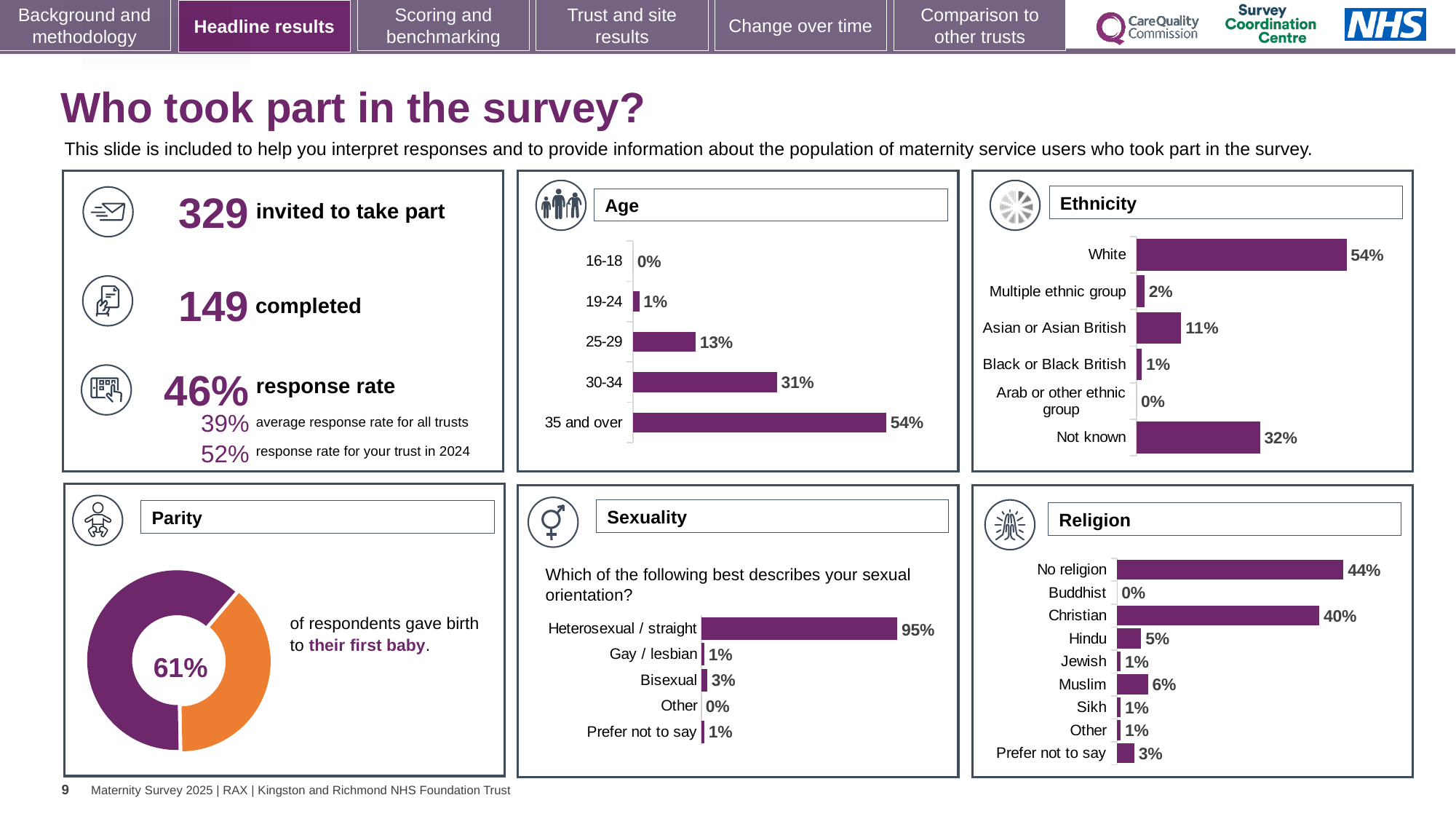
What kind of chart is the Parity chart? Doughnut chart In the Ethnicity chart, which category has the highest value? White In the Age chart, what percentage of respondents were aged 35 and over? 54% In the Age chart, which age group has the lowest value? 16-18 In the Parity chart, what share of respondents gave birth to their first baby? 61% In the Religion chart, what is the value for Muslim? 6% In the Sexuality chart, what is the value for Bisexual? 3% In the Age chart, what is the difference between the 30-34 and 25-29 values? 18% In the Religion chart, what is the difference between No religion and Christian? 4% In the Ethnicity chart, what is the value for Asian or Asian British? 11% In the Ethnicity chart, how many categories are shown? 6 In the Sexuality chart, which is larger, Gay / lesbian or Bisexual? Bisexual